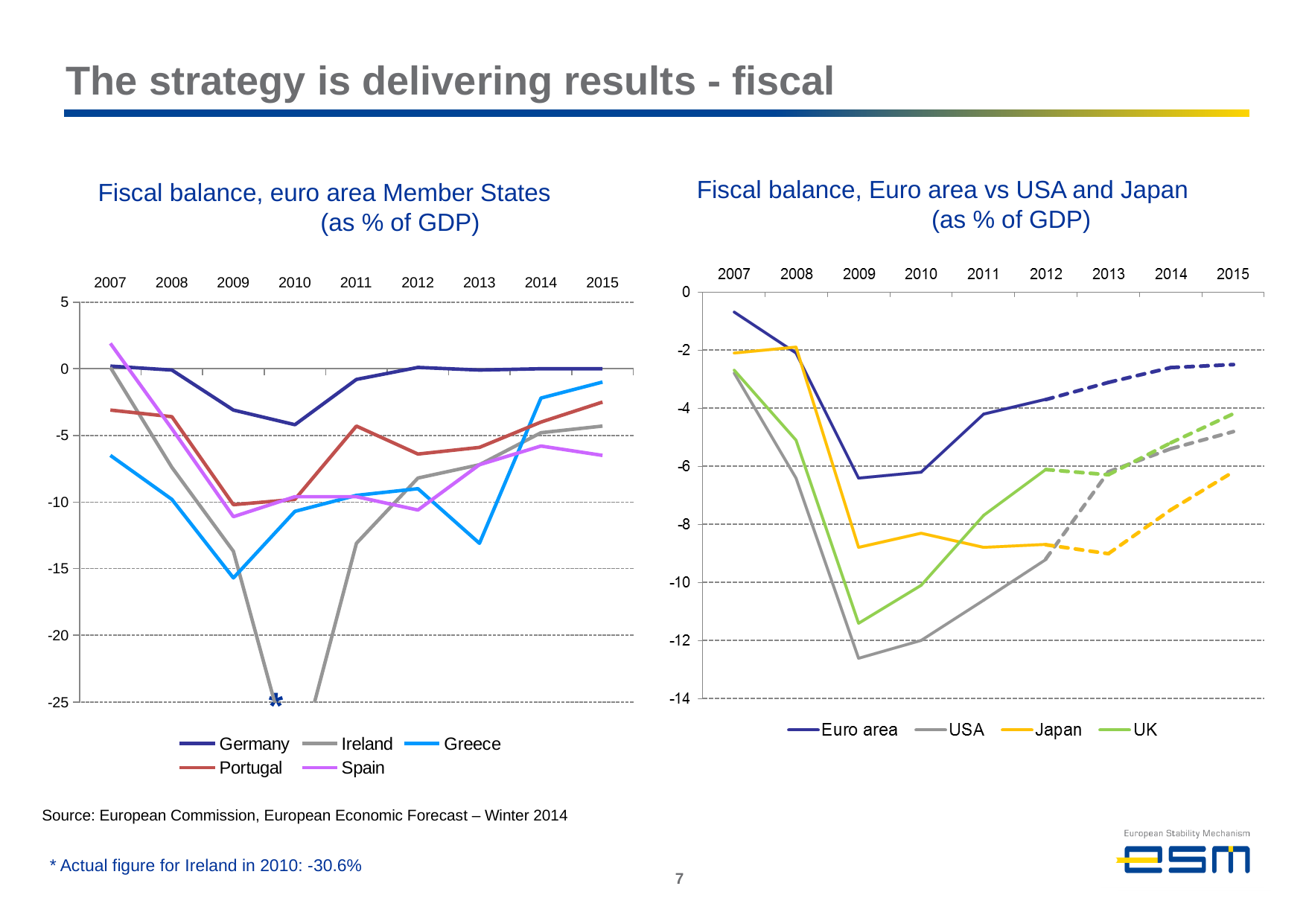
In the left chart, 'Fiscal balance, euro area Member States', is the value for Germany in 2010 greater or less than -5? greater In the left chart, 'Fiscal balance, euro area Member States', what is the actual figure for Ireland in 2010 according to the footnote? -30.6% In the left chart, 'Fiscal balance, euro area Member States', which is larger in 2014, the value for Greece or the value for Portugal? Greece What type of chart is the left chart, 'Fiscal balance, euro area Member States'? Line chart In the right chart, 'Fiscal balance, Euro area vs USA and Japan', which series has the lowest value in 2009? USA How many series does the legend of the right chart, 'Fiscal balance, Euro area vs USA and Japan', list? 4 How many series does the legend of the left chart, 'Fiscal balance, euro area Member States', list? 5 In the left chart, 'Fiscal balance, euro area Member States', which country has the highest fiscal balance in 2007? Spain In the left chart, 'Fiscal balance, euro area Member States', which country has the lowest fiscal balance in 2010? Ireland In the right chart, 'Fiscal balance, Euro area vs USA and Japan', does the Euro area line rise or fall from 2009 to 2015? Rise How many years are shown on the x axis of the right chart, 'Fiscal balance, Euro area vs USA and Japan'? 9 In the right chart, 'Fiscal balance, Euro area vs USA and Japan', is the value for the UK in 2009 greater or less than -10? less